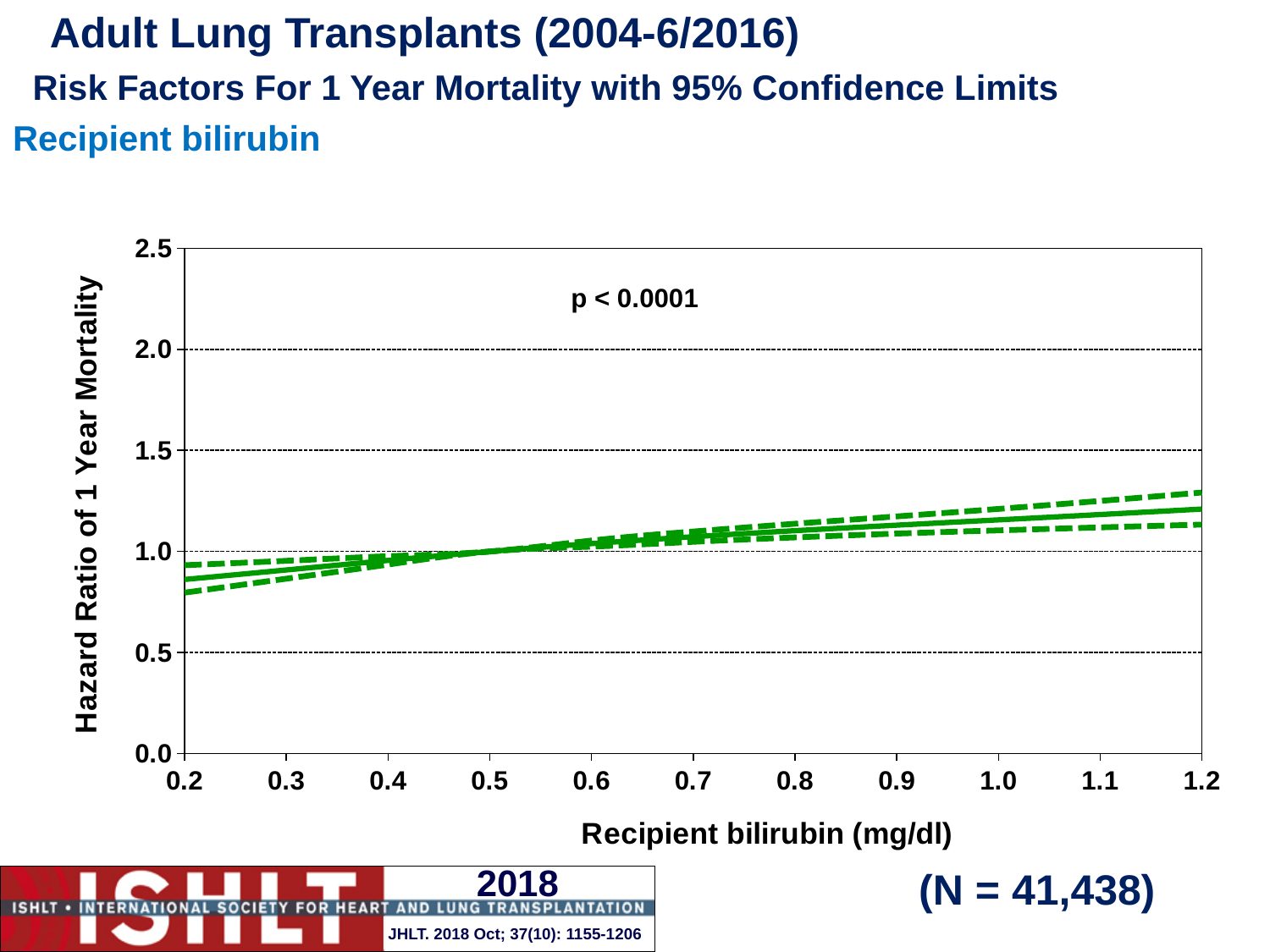
What kind of chart is shown on the slide? Line chart What is the maximum value shown on the y axis? 2.5 How many lines are plotted on the chart (the estimate plus its confidence limits)? 3 What is the label of the x axis? Recipient bilirubin (mg/dl) Does the hazard ratio of 1 year mortality rise or fall as recipient bilirubin increases from 0.2 to 1.2 mg/dl? Rise Is the hazard ratio at a recipient bilirubin of 1.2 mg/dl greater or less than 1.0? greater What p-value is printed on the chart? p < 0.0001 Is the hazard ratio at a recipient bilirubin of 0.2 mg/dl greater or less than 1.0? less Is the hazard ratio at a recipient bilirubin of 0.2 mg/dl greater or less than 0.5? greater What is the lowest recipient bilirubin value shown on the x axis? 0.2 Which has the higher hazard ratio: a recipient bilirubin of 0.2 mg/dl or 1.2 mg/dl? 1.2 mg/dl